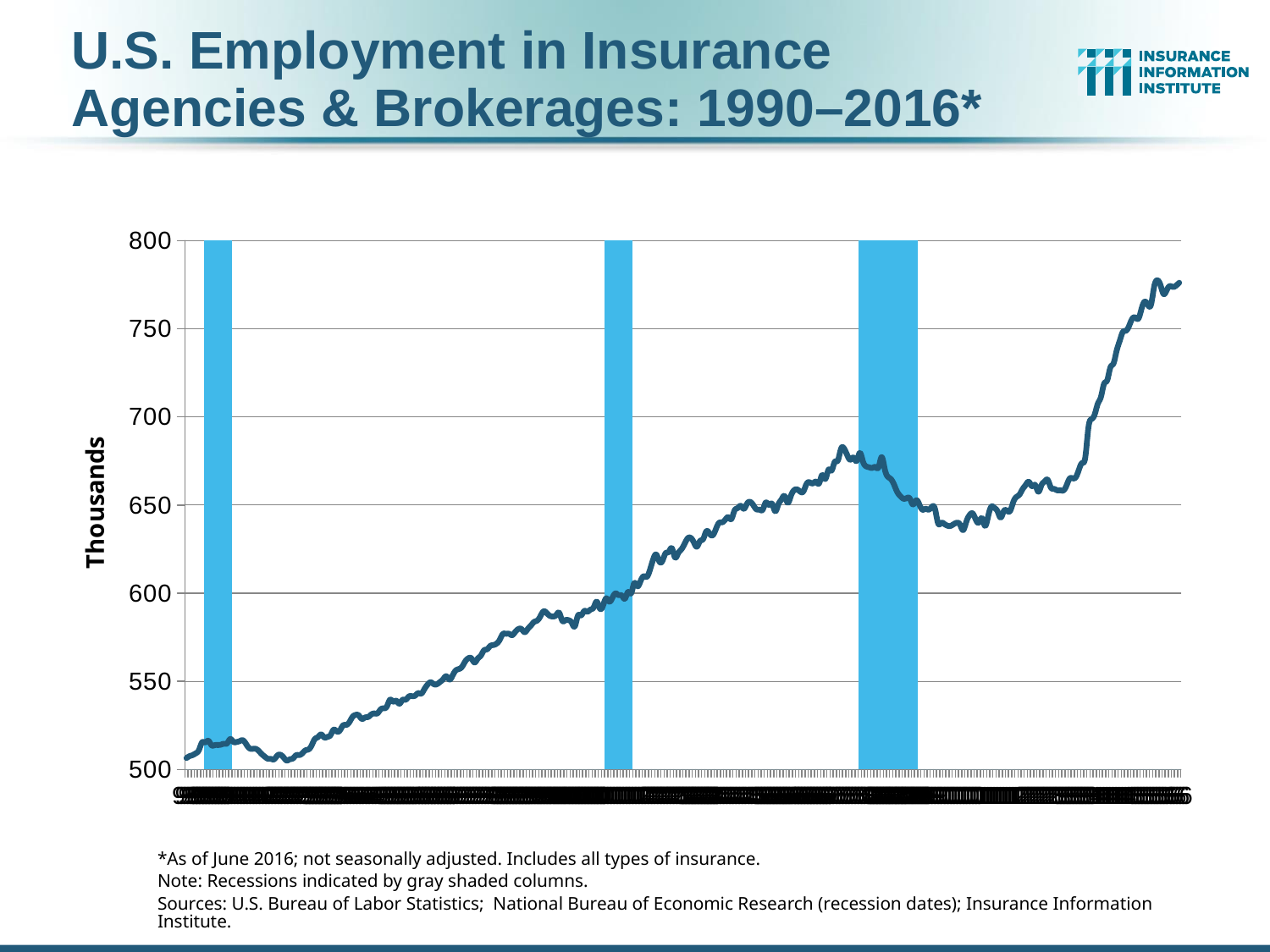
What is the label on the vertical axis of the chart? Thousands What is the title of the chart on the slide? U.S. Employment in Insurance Agencies & Brokerages: 1990–2016* Is the value at the left end of the line (1990) greater or less than 550? less Is the lowest point of the line greater or less than 550? less Is the value at the right end of the line (June 2016) greater or less than 750? greater What kind of chart is shown on the slide? line chart Overall, does the line rise or fall from the left end of the chart to the right end? rise Is the value at the right end of the line greater or less than the value at the left end of the line? greater What is the highest value shown on the vertical axis? 800